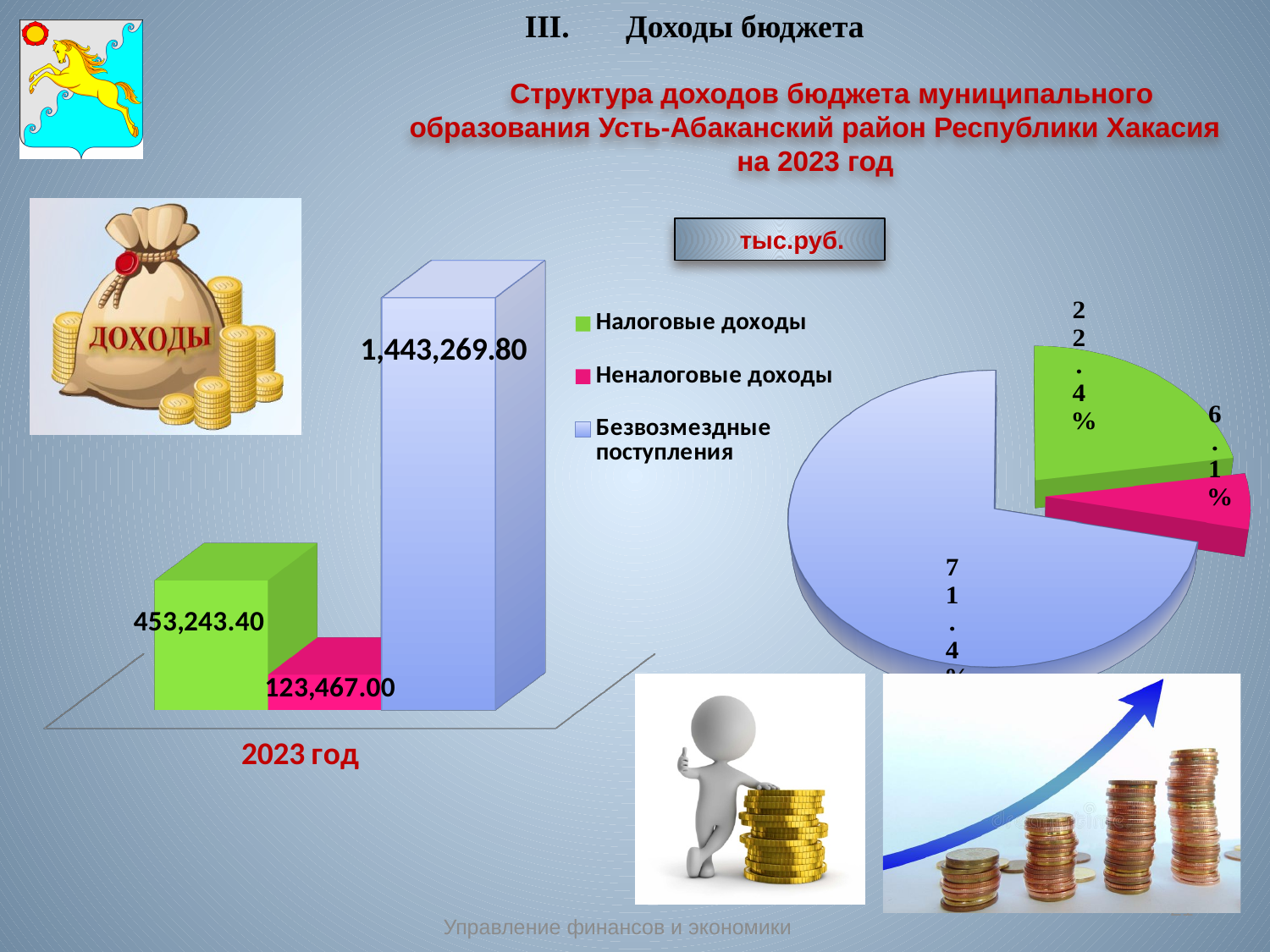
In the pie chart on the right, which category has the largest slice? Безвозмездные поступления In the pie chart on the right, what share is shown for Налоговые доходы (green slice)? 22.4% In the bar chart on the left, what is the value for Налоговые доходы? 453,243.40 How many series does the legend list? 3 In the bar chart on the left, which is larger: Налоговые доходы or Неналоговые доходы? Налоговые доходы In the bar chart on the left, which series has the highest value? Безвозмездные поступления What kind of chart is the chart on the left of the slide? bar chart In the bar chart on the left, what is the difference between Налоговые доходы and Неналоговые доходы? 329,776.40 In the bar chart on the left, what is the value for Безвозмездные поступления? 1,443,269.80 In the pie chart on the right, what share is shown for Неналоговые доходы (pink slice)? 6.1% In the bar chart on the left, what is the value for Неналоговые доходы? 123,467.00 In the bar chart on the left, which series has the lowest value? Неналоговые доходы